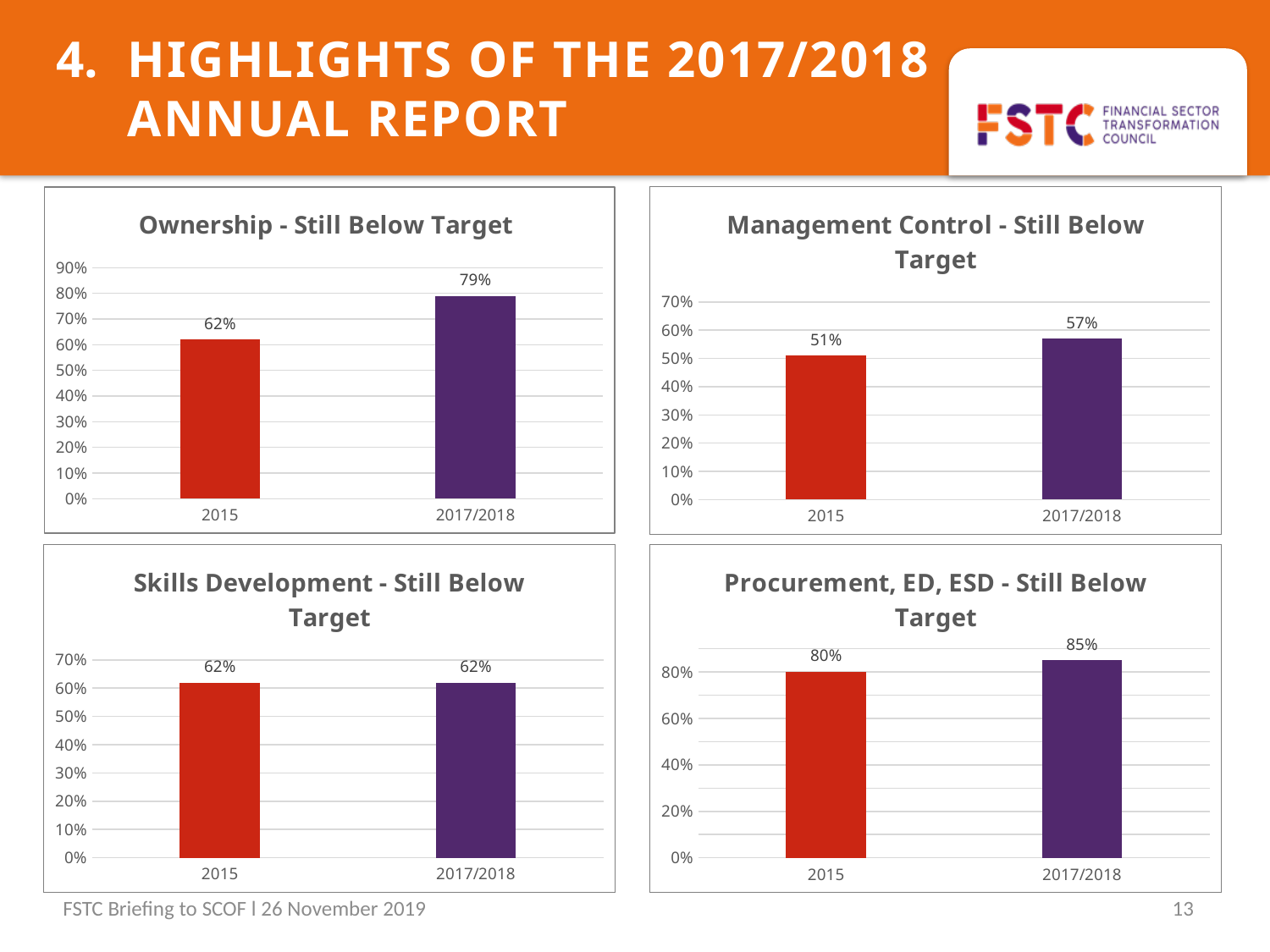
In the 'Ownership - Still Below Target' chart, what is the difference between the 2017/2018 and 2015 values? 17% In the 'Management Control - Still Below Target' chart, what is the value for 2015? 51% How many categories are shown on the x axis of the 'Skills Development - Still Below Target' chart? 2 In the 'Procurement, ED, ESD - Still Below Target' chart, what is the value for 2015? 80% In the 'Ownership - Still Below Target' chart, what is the value for 2015? 62% In the 'Management Control - Still Below Target' chart, what is the difference between the 2017/2018 and 2015 values? 6% How many charts are shown on the slide? 4 In the 'Skills Development - Still Below Target' chart, what is the value for 2017/2018? 62% In the 'Management Control - Still Below Target' chart, is the value for 2015 greater or less than 60%? less In the 'Procurement, ED, ESD - Still Below Target' chart, which year has the higher value? 2017/2018 What kind of chart is the 'Ownership - Still Below Target' chart? Bar chart In the 'Ownership - Still Below Target' chart, what is the value for 2017/2018? 79%